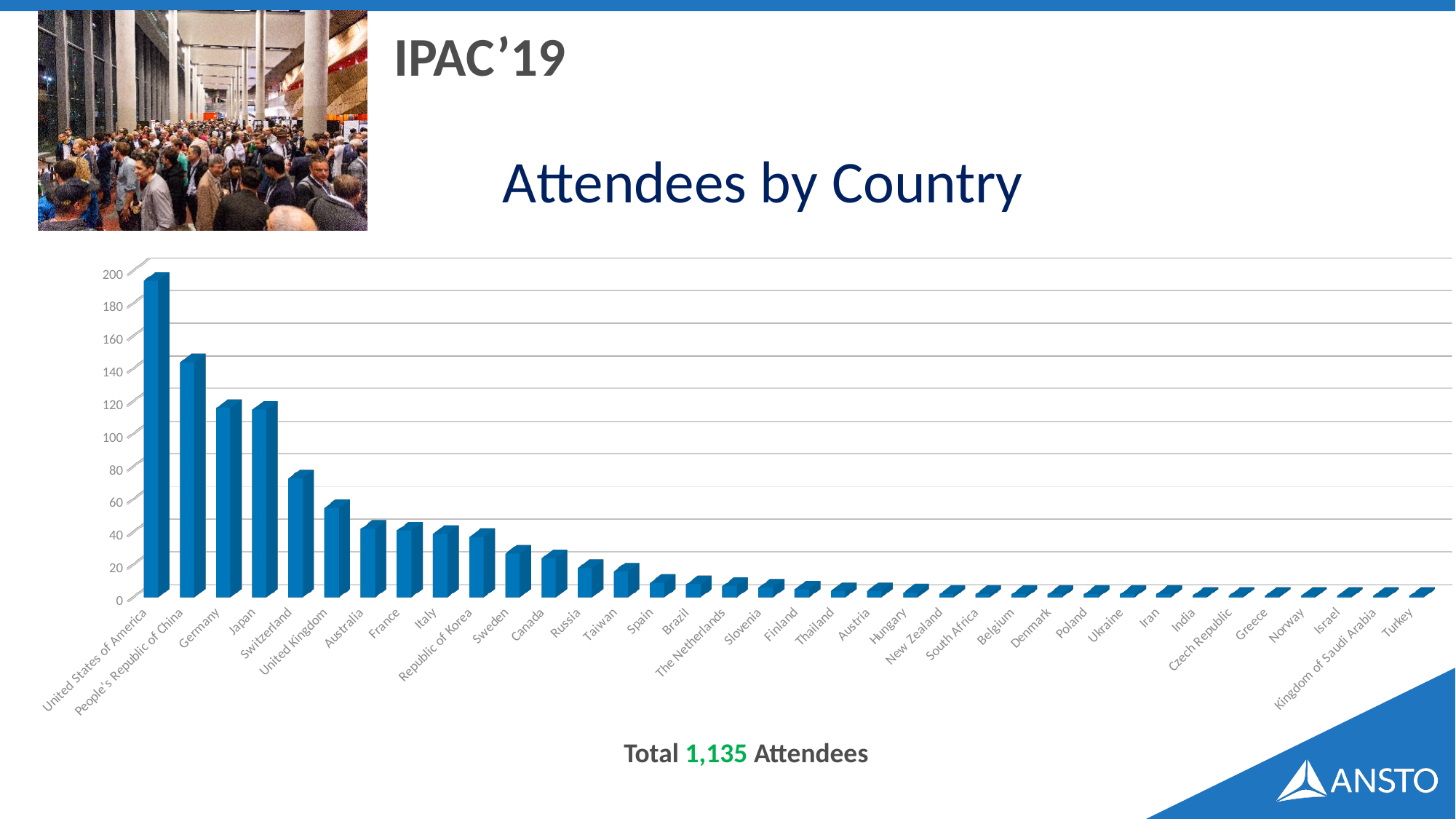
Is the value for United States of America greater or less than 180? greater Is the value for People's Republic of China greater or less than 120? greater Which has more attendees, United States of America or People's Republic of China? United States of America What kind of chart is shown on the slide? bar chart Do the values rise or fall moving from left to right along the x axis? fall Which country has the highest number of attendees? United States of America Is the value for Sweden greater or less than 40? less What is the title of the chart? Attendees by Country How many countries are shown on the x axis? 36